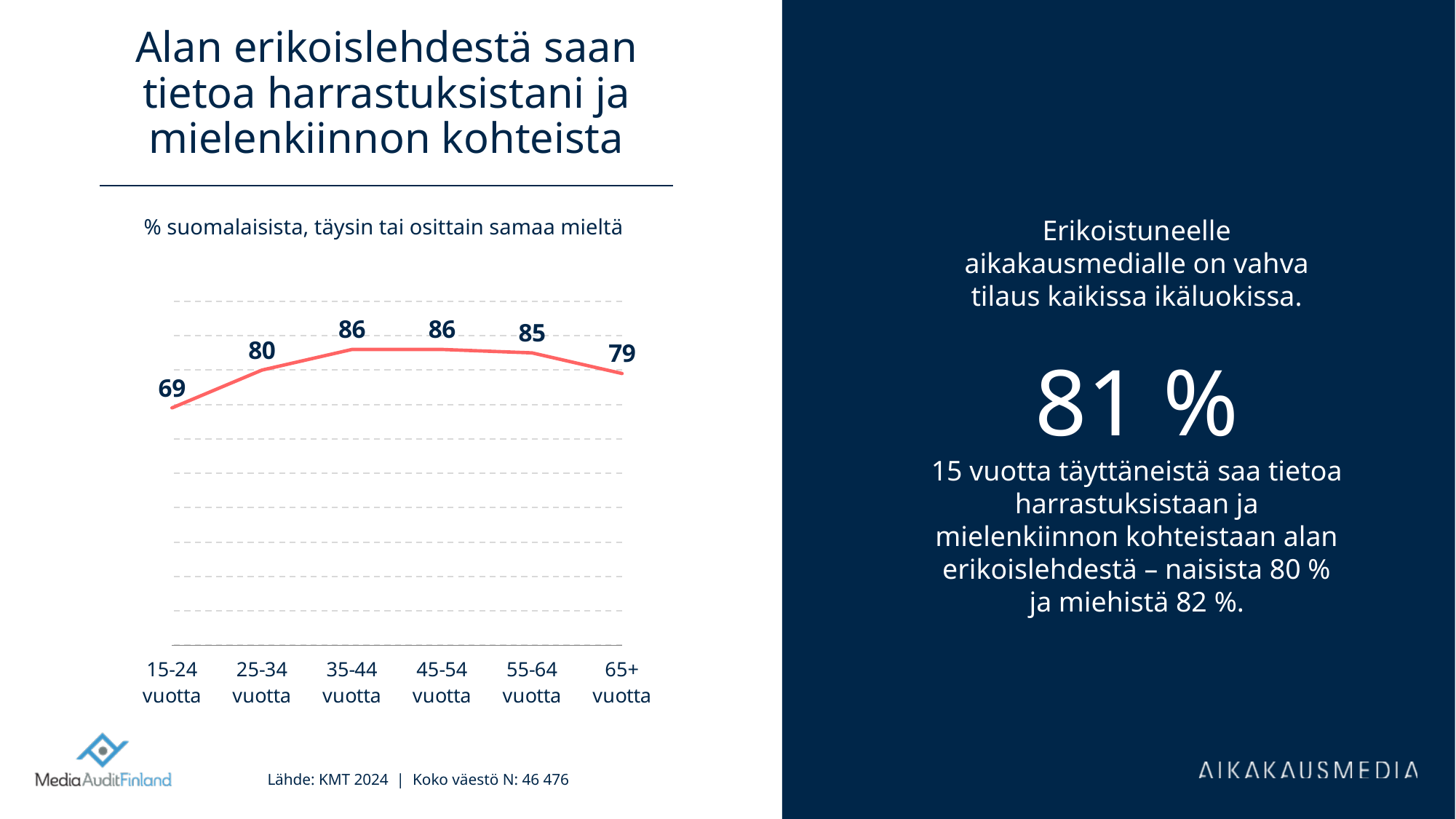
What is the difference between the values for 35-44 vuotta and 15-24 vuotta? 17 Which is larger, the value for 45-54 vuotta or the value for 65+ vuotta? 45-54 vuotta How many age groups are plotted on the chart? 6 Which age group has the lowest value? 15-24 vuotta What is the value for 15-24 vuotta? 69 What is the value for 25-34 vuotta? 80 Do the values rise or fall from 15-24 vuotta to 35-44 vuotta? Rise What is the difference between the values for 55-64 vuotta and 65+ vuotta? 6 What kind of chart is shown on the slide? Line chart What is the highest value shown on the chart? 86 What is the value for 65+ vuotta? 79 What is the value for 55-64 vuotta? 85